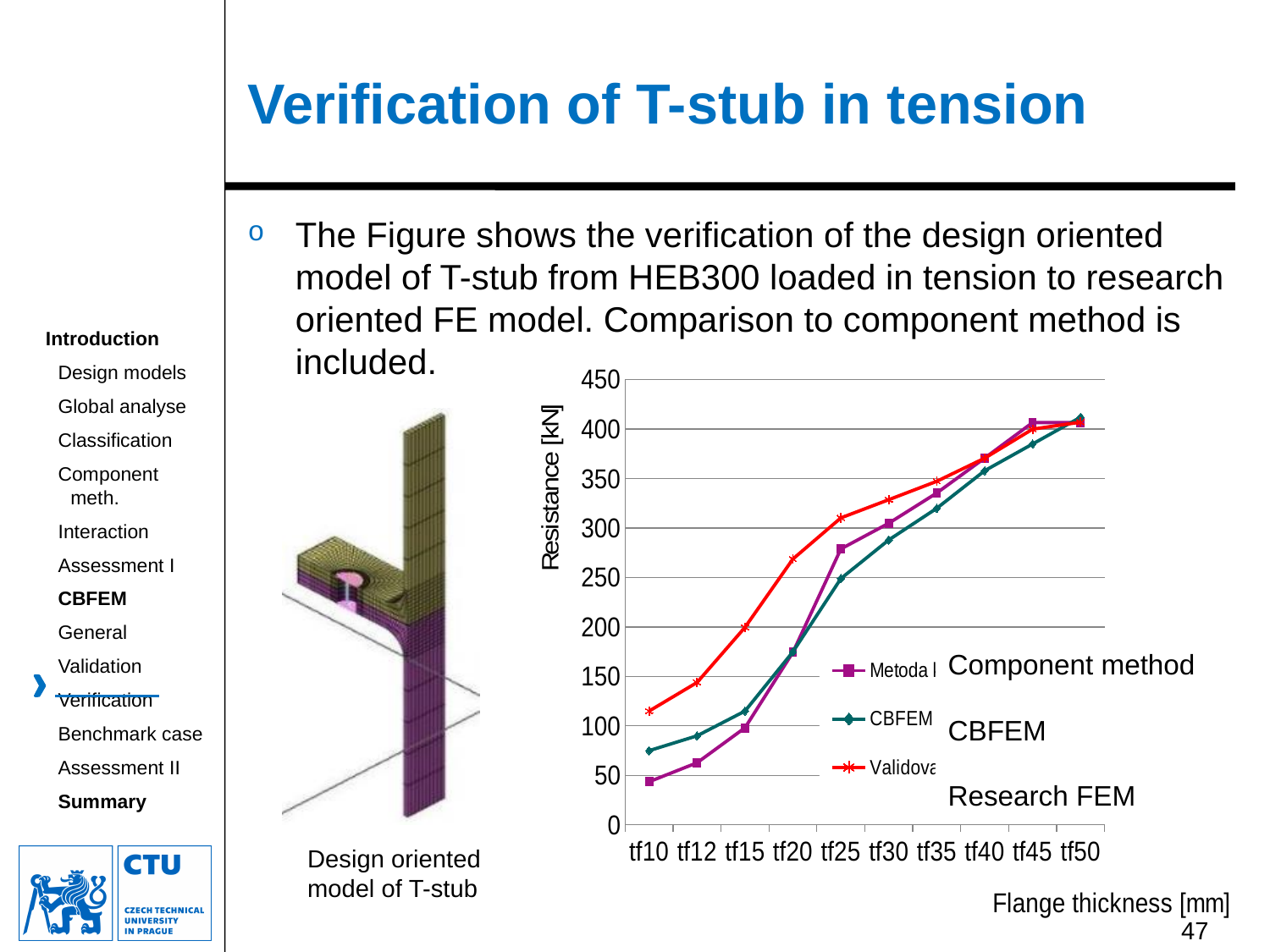
Is the resistance for the CBFEM series at tf35 greater or less than 300? greater Is the resistance for the Component method series at tf25 greater or less than 250? greater At tf25, which series has the larger resistance, Component method or CBFEM? Component method What is the label of the y axis of the chart? Resistance [kN] Is the resistance for the Research FEM series at tf10 greater or less than 100? greater What kind of chart is shown on the slide? line chart How many series does the chart's legend list? 3 Which series has the highest resistance at tf10? Research FEM Which series has the lowest resistance at tf10? Component method Do the resistance values for the CBFEM series rise or fall as flange thickness increases from tf10 to tf50? rise How many flange thickness categories are shown on the x axis of the chart? 10